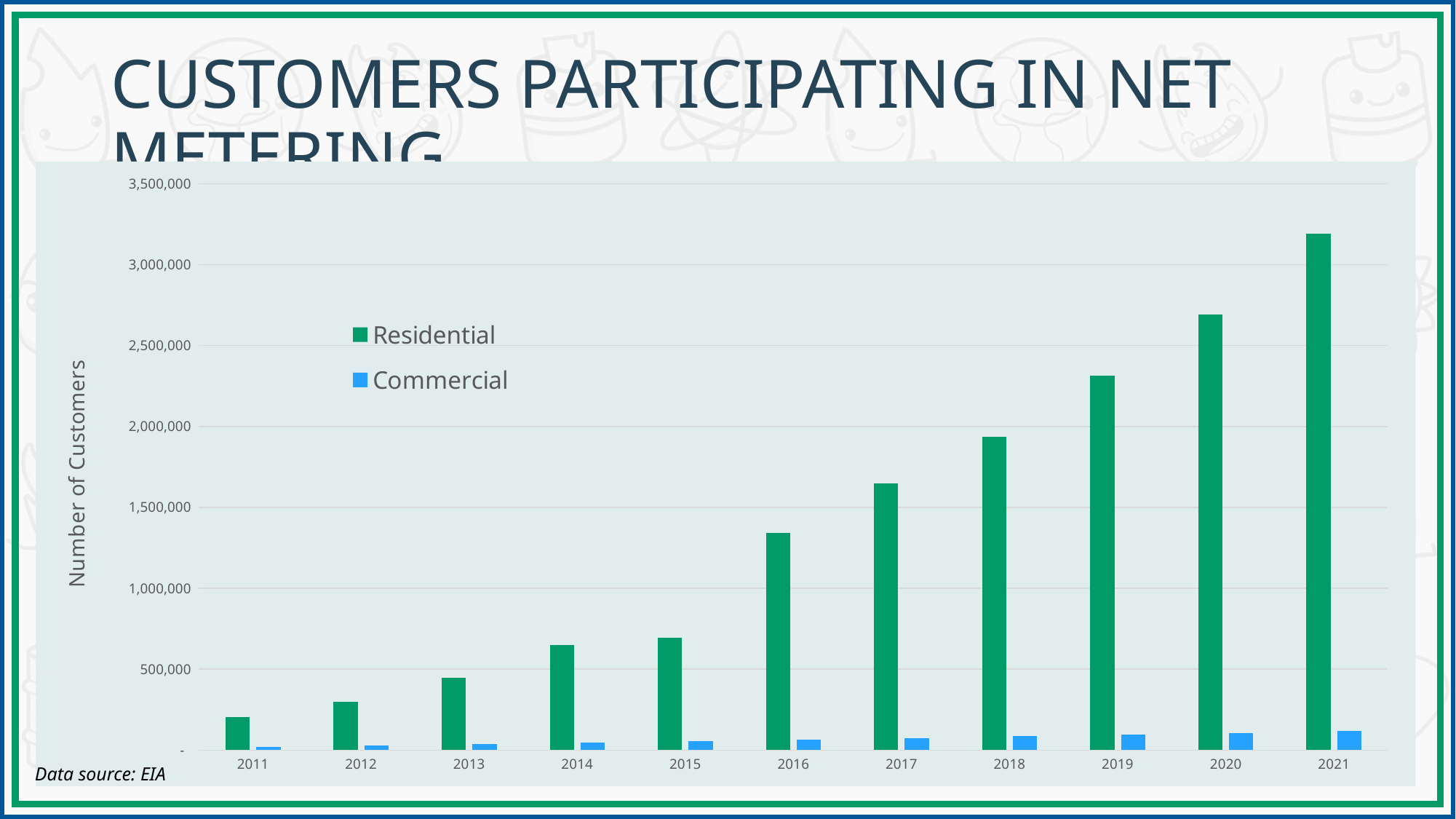
How many series does the legend list? 2 Which year has the lowest Residential value? 2011 Is the Residential value for 2019 greater or less than 2,000,000? greater Do the Residential values rise or fall from 2011 to 2021? Rise Which is larger in 2020, the Residential value or the Commercial value? Residential What kind of chart is shown on the slide? Bar chart Which year has the highest Residential value? 2021 What is the label of the y axis? Number of Customers How many years are shown on the x axis? 11 Is the Residential value for 2016 greater or less than 1,500,000? less Is the Residential value for 2021 greater or less than 3,000,000? greater